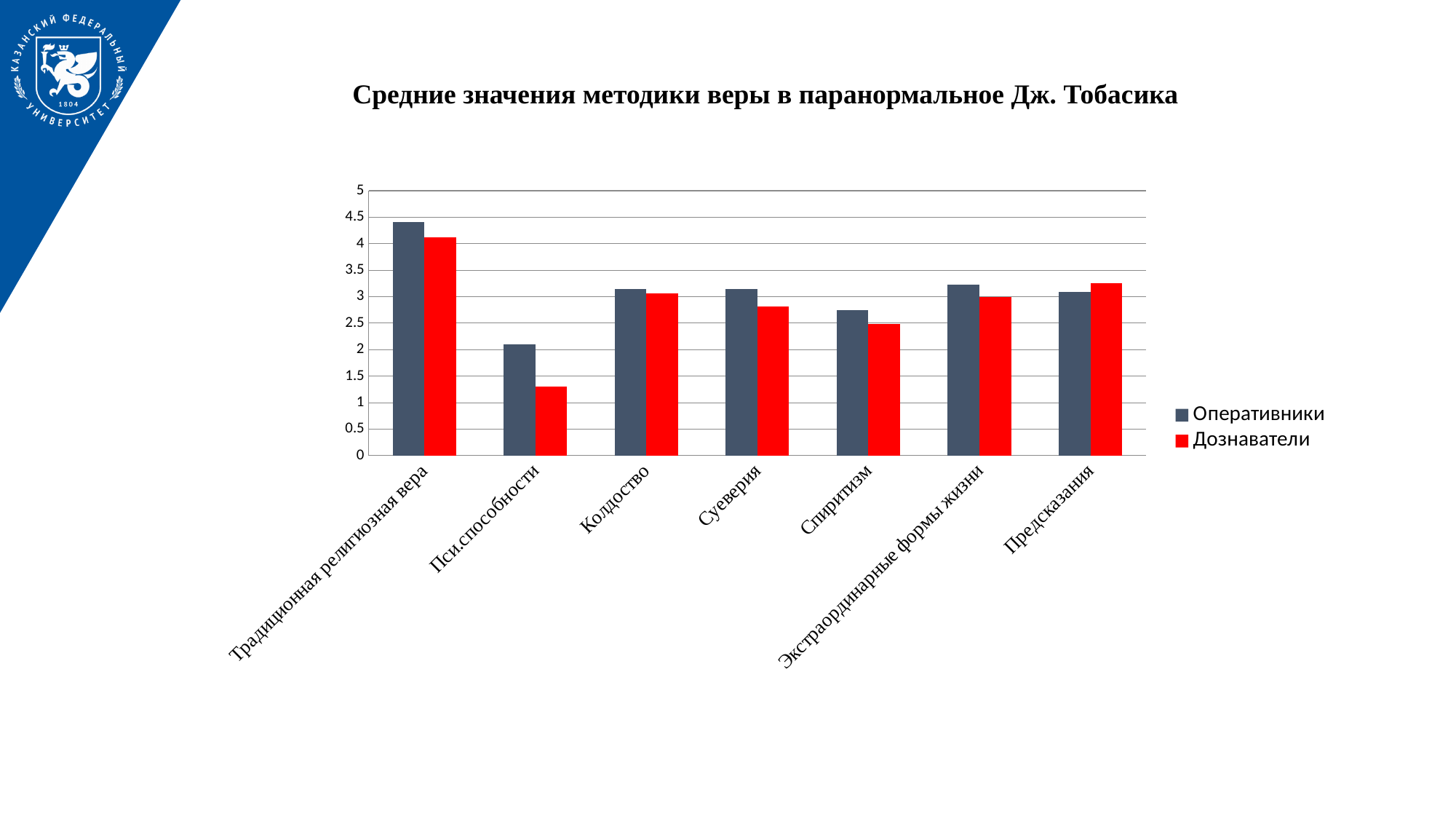
How many series does the legend list? 2 Is the value for Оперативники in Традиционная религиозная вера greater or less than 4? greater Is the value for Дознаватели in Пси.способности greater or less than 1.5? less For Пси.способности, which series has the larger value, Оперативники or Дознаватели? Оперативники Is the value for Оперативники in Спиритизм greater or less than 3? less For the Оперативники series, which category has the highest value? Традиционная религиозная вера For the Дознаватели series, which category has the lowest value? Пси.способности How many categories are shown on the x axis of the chart? 7 What is the title of the chart? Средние значения методики веры в паранормальное Дж. Тобасика Which series is shown in red in the chart? Дознаватели What kind of chart is shown on the slide? bar chart For Предсказания, which series has the larger value, Оперативники or Дознаватели? Дознаватели